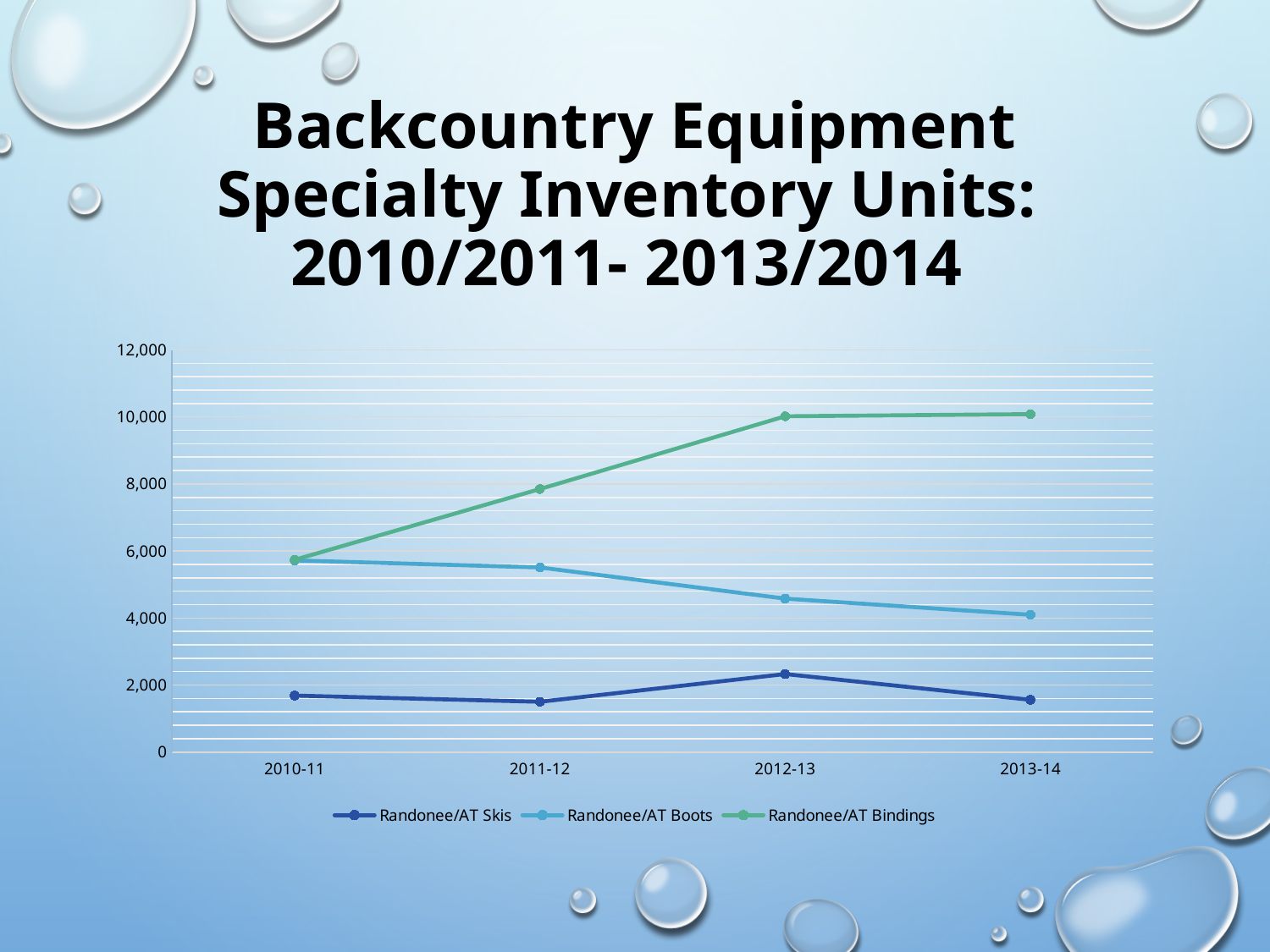
Is the value for Randonee/AT Boots in 2012-13 greater or less than 6,000? less In 2010-11, which is larger: Randonee/AT Boots or Randonee/AT Skis? Randonee/AT Boots What kind of chart is shown on the slide? line chart What is the title of the chart on the slide? Backcountry Equipment Specialty Inventory Units: 2010/2011- 2013/2014 Which series has the highest value in 2013-14? Randonee/AT Bindings How many seasons are plotted along the x axis? 4 Do the values for Randonee/AT Boots rise or fall from 2010-11 to 2013-14? fall Is the value for Randonee/AT Skis in 2012-13 greater or less than 2,000? greater Do the values for Randonee/AT Bindings rise or fall from 2010-11 to 2013-14? rise How many series does the legend list? 3 Is the value for Randonee/AT Bindings in 2011-12 greater or less than 6,000? greater Which series has the lowest value in 2012-13? Randonee/AT Skis